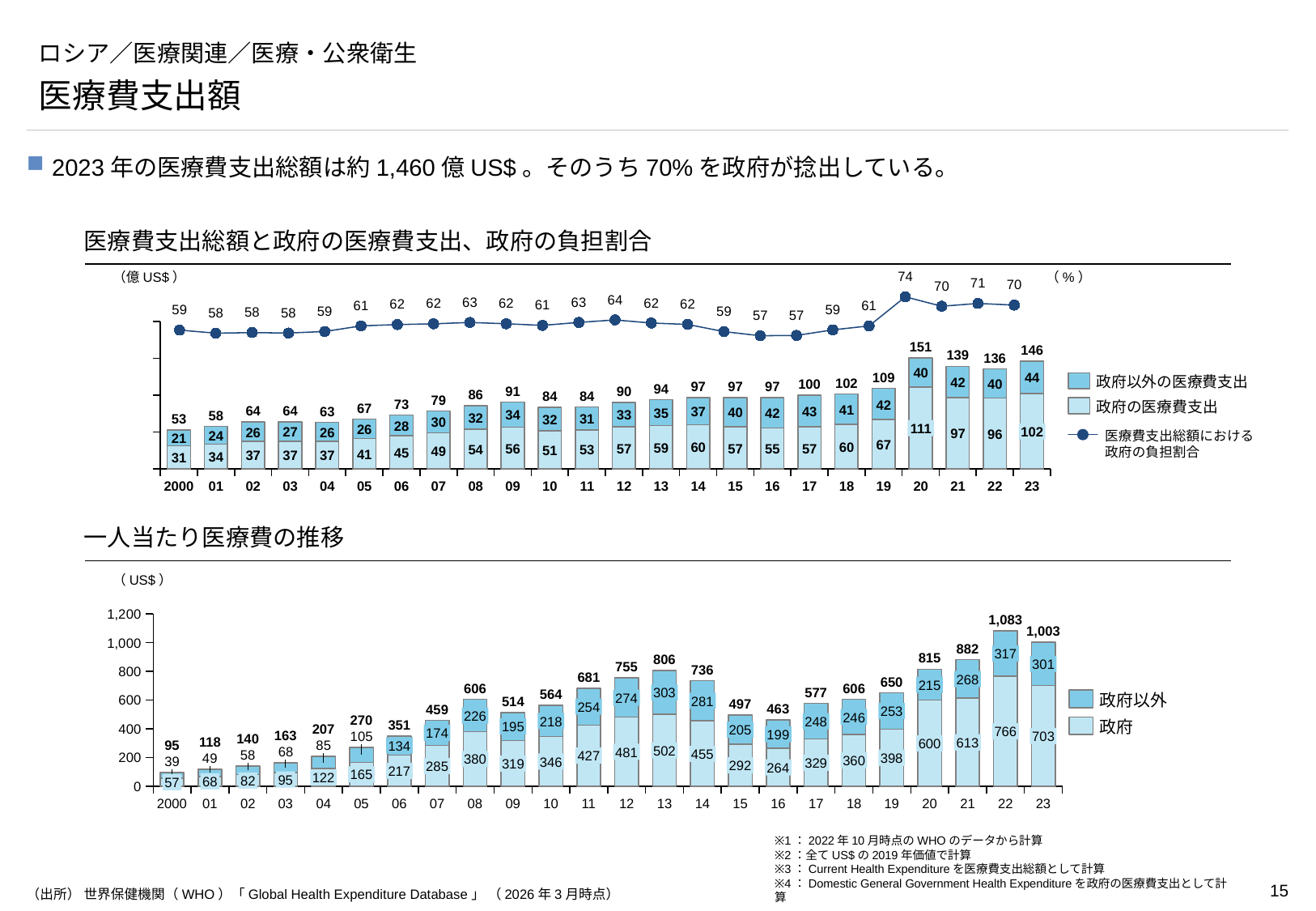
In the top chart, which year has the lowest total health expenditure bar? 2000 In the top chart, how many entries does the legend list? 3 In the bottom chart, which year has the highest total per-capita health expenditure? 2022 What kind of chart is the bottom chart (一人当たり医療費の推移)? Stacked bar chart In the bottom chart, is the total per-capita value for 2013 greater or less than 800? greater In the top chart, what is the difference between the government health expenditure (政府の医療費支出) in 2020 and in 2023? 9 In the top chart, what is the government's share of total health expenditure (政府の負担割合) in 2020? 74 In the bottom chart (一人当たり医療費の推移), what is the total per-capita health expenditure for 2022? 1,083 In the bottom chart, how many years are shown on the x axis? 24 In the top chart (医療費支出総額と政府の医療費支出、政府の負担割合), what is the total health expenditure for 2023? 146 In the bottom chart, what is the government (政府) per-capita value for 2023? 703 In the top chart, which year has the highest total health expenditure bar? 2020